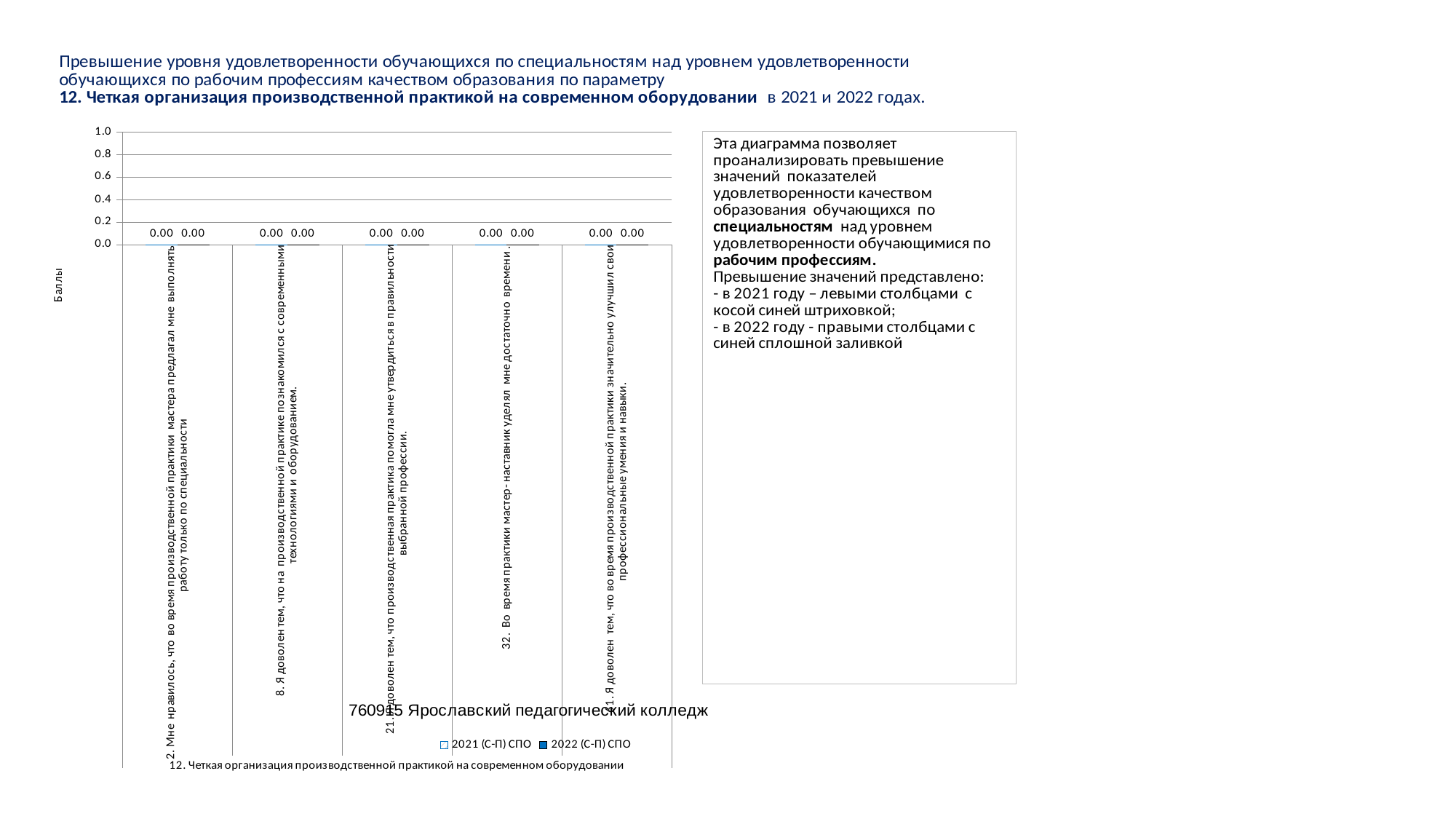
What kind of chart is shown on the slide? bar chart How many series does the chart legend list? 2 What is the title of the vertical axis of the chart? Баллы What is the value of the 2022 (С-П) СПО series for category 2 (Мне нравилось, что во время производственной практики мастера предлагал мне выполнять работу только по специальности)? 0.00 What is the value of the 2022 (С-П) СПО series for category 32 (Во время практики мастер-наставник уделял мне достаточно времени)? 0.00 How many categories are plotted along the x axis of the chart? 5 Is the value of the 2021 (С-П) СПО series for category 8 greater or less than 0.2? less What are the two series names listed in the chart legend? 2021 (С-П) СПО and 2022 (С-П) СПО What is the value of the 2021 (С-П) СПО series for category 8 (Я доволен тем, что на производственной практике познакомился с современными технологиями и оборудованием)? 0.00 What is the highest tick value shown on the vertical axis of the chart? 1.0 What is the difference between the 2022 (С-П) СПО and 2021 (С-П) СПО values for category 21 (Я доволен тем, что производственная практика помогла мне утвердиться в правильности выбранной профессии)? 0.00